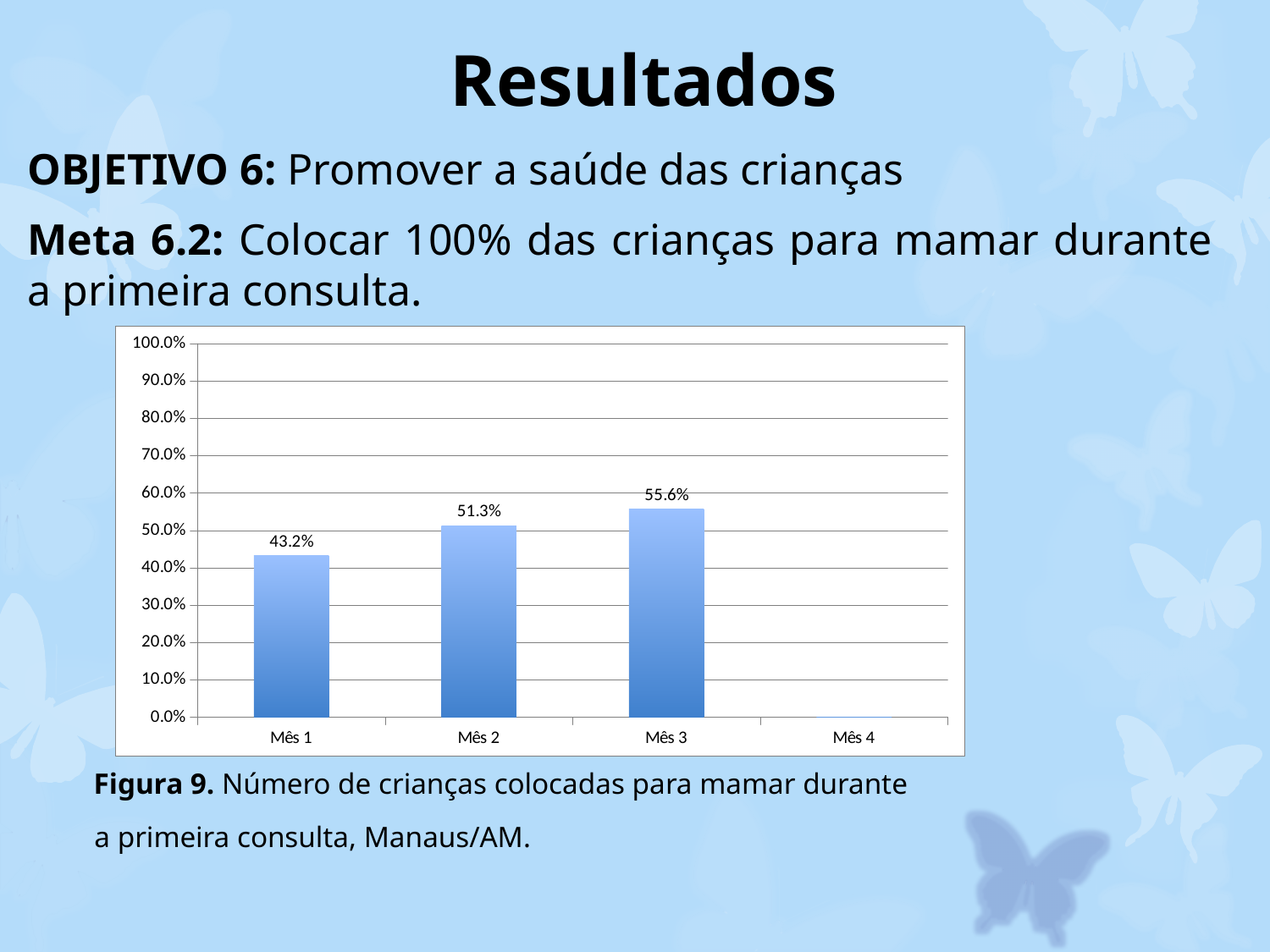
What kind of chart is shown on the slide? bar chart Which month has the highest value among the bars shown? Mês 3 How many categories are shown on the x axis? 4 What is the difference between the values for Mês 2 and Mês 1? 8.1% Which month has the lowest value among the bars shown? Mês 1 What is the value for Mês 3? 55.6% Which is larger, the value for Mês 2 or the value for Mês 3? Mês 3 Do the values rise or fall from Mês 1 to Mês 3? rise What is the value for Mês 1? 43.2% What is the difference between the values for Mês 3 and Mês 1? 12.4% What is the value for Mês 2? 51.3% Is the value for Mês 1 greater or less than 50.0%? less